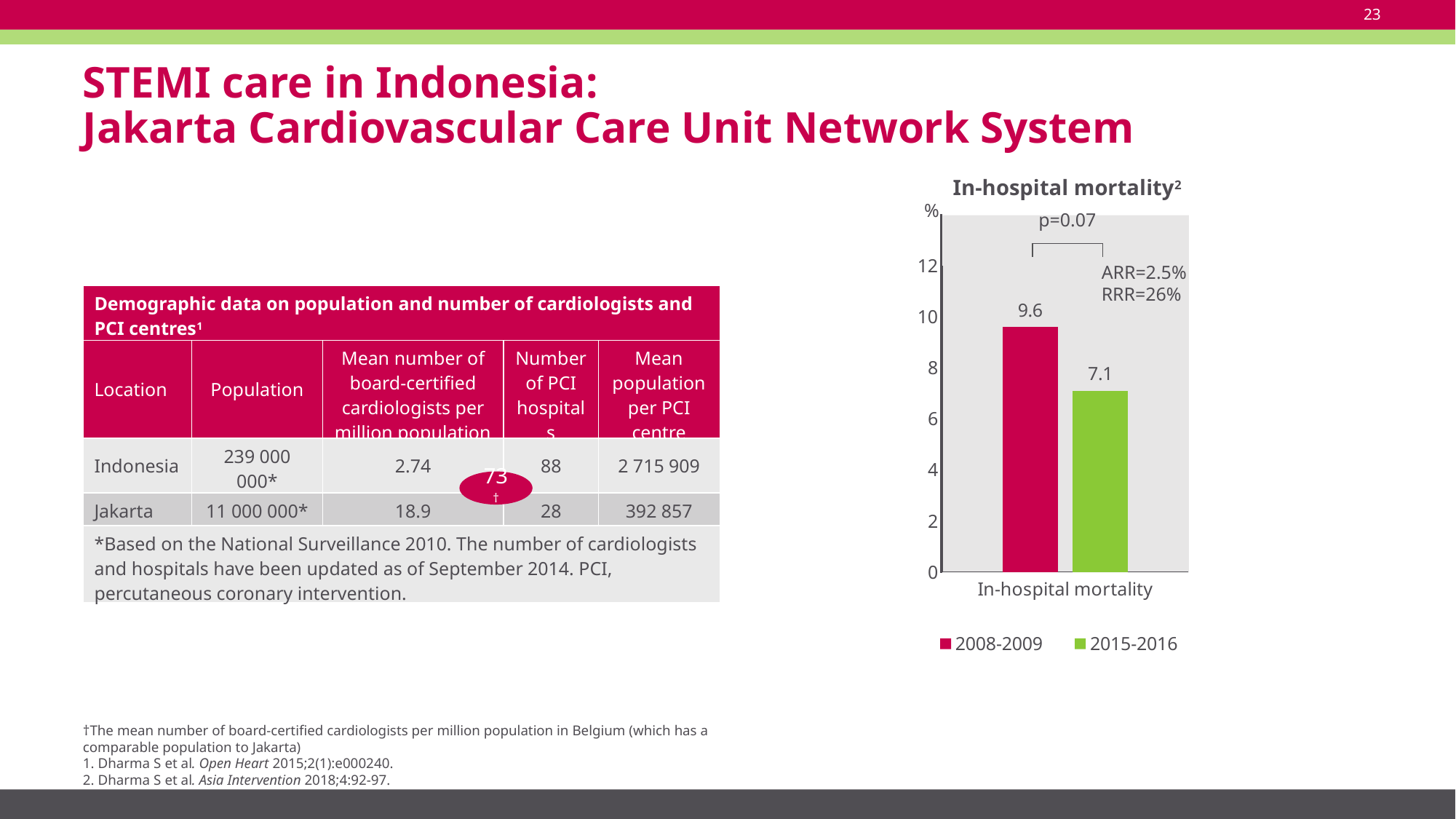
What is the in-hospital mortality value for 2015-2016? 7.1 What is the in-hospital mortality value for 2008-2009? 9.6 Is the in-hospital mortality for 2015-2016 larger or smaller than for 2008-2009? smaller What is the difference in in-hospital mortality between 2008-2009 and 2015-2016? 2.5 What kind of chart is used to show in-hospital mortality? bar chart Is the in-hospital mortality for 2008-2009 greater or less than 8? greater What is the title of the chart on the slide? In-hospital mortality How many series does the legend of the in-hospital mortality chart list? 2 What p-value is shown on the in-hospital mortality chart? p=0.07 Is the in-hospital mortality for 2015-2016 greater or less than 8? less Which period has the lower in-hospital mortality? 2015-2016 Which period has the higher in-hospital mortality? 2008-2009